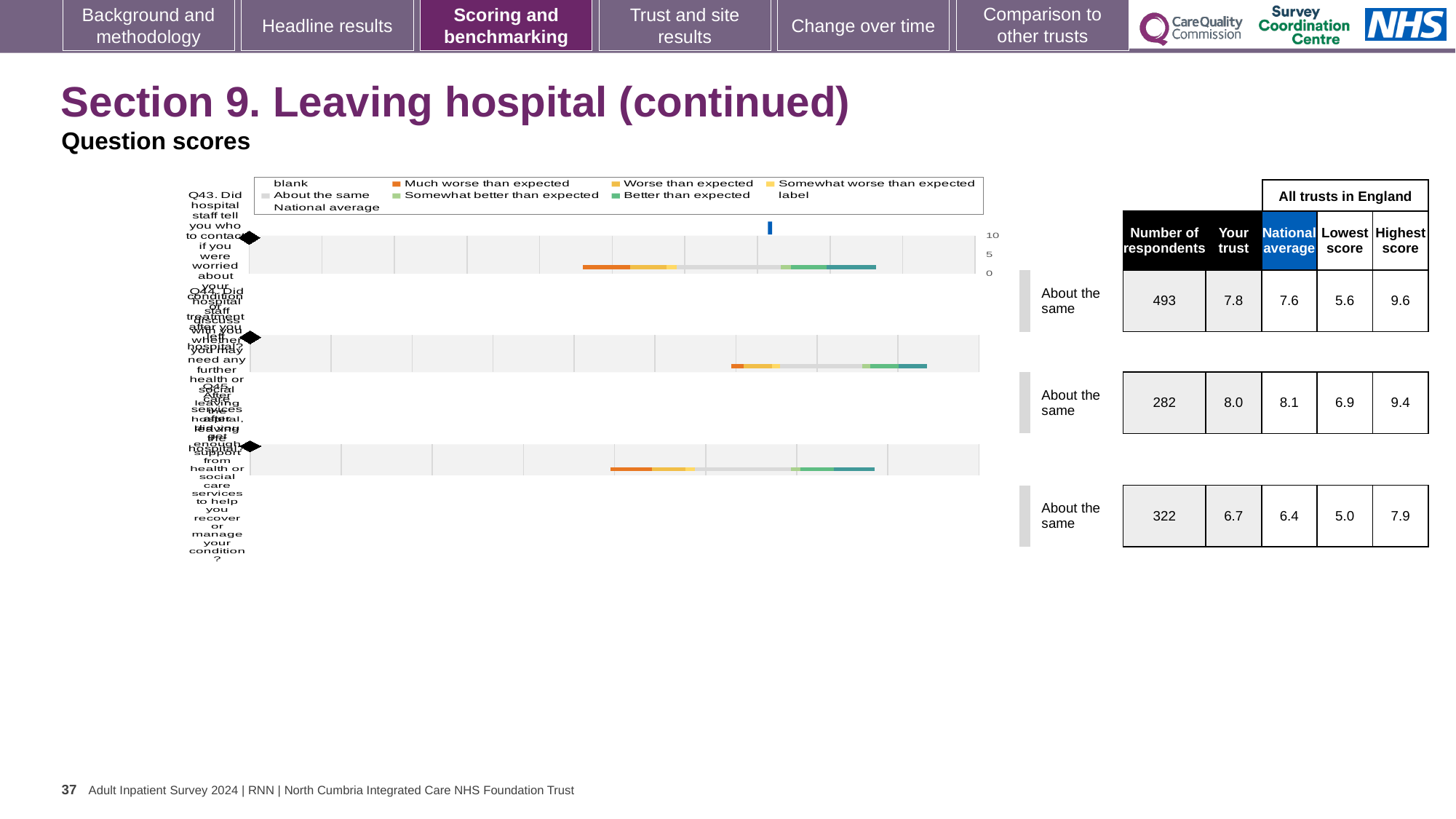
How many respondents are listed for the third row (Q45)? 322 Which question has the highest 'Your trust' score? Q44 How many questions (rows) are plotted in the chart? 3 What benchmark category is shown for all three questions? About the same What is the national average for the second row (Q44)? 8.1 For Q43, what is the difference between the highest score and the lowest score across all trusts in England? 4.0 What kind of chart is shown on the slide? bar chart What is the 'Your trust' score for the first row (Q43)? 7.8 What is the lowest score across all trusts in England for the third row (Q45)? 5.0 Which question has the lowest 'Your trust' score? Q45 How many entries does the chart legend list? 9 For Q43, which is larger: the 'Your trust' score or the national average? Your trust